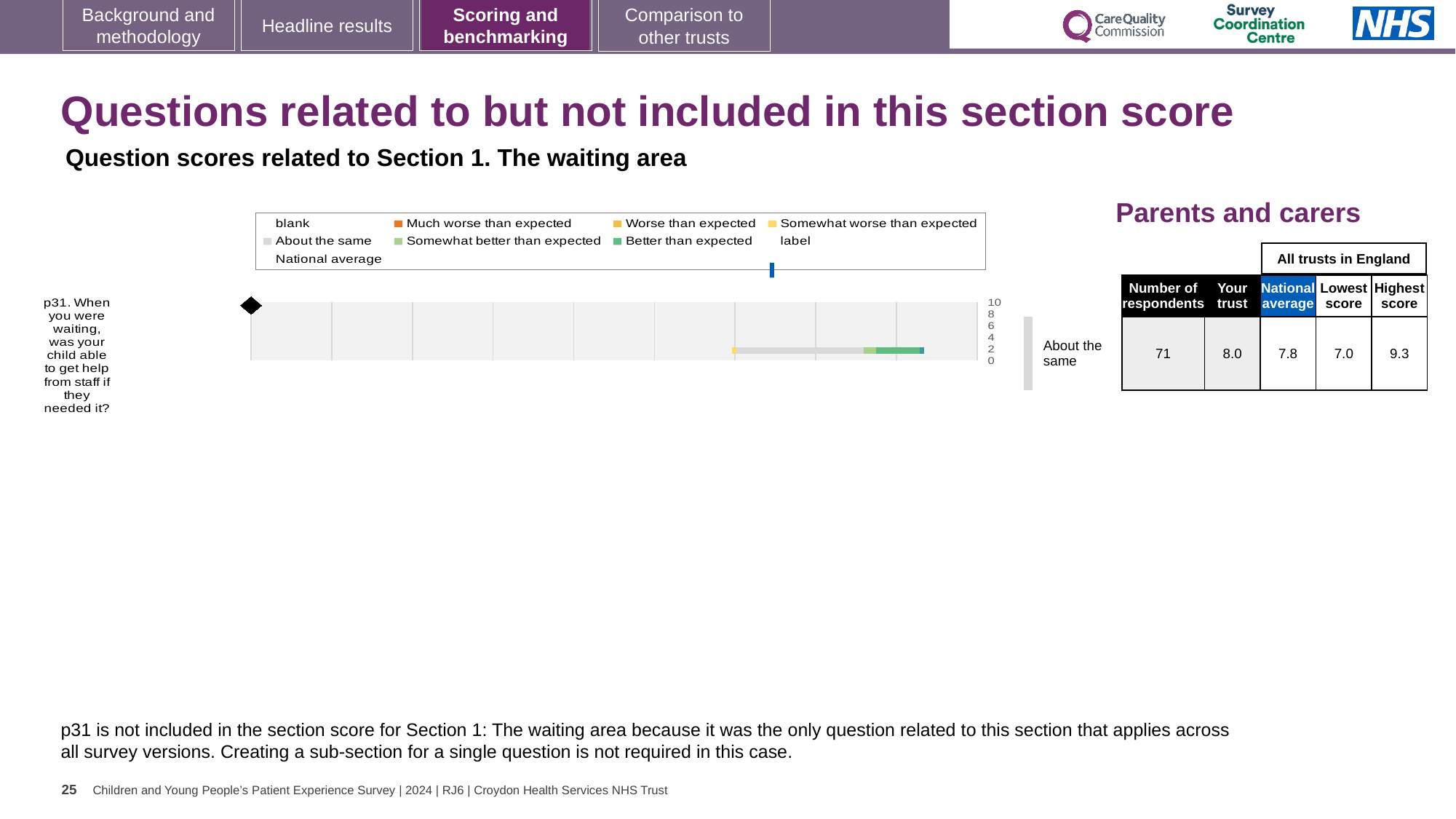
What is the highest score among all trusts in England for p31? 9.3 How many questions (categories) are plotted in the chart? 1 What is the 'Your trust' score for p31 in the table? 8.0 What is the difference between the 'Your trust' score and the national average for p31? 0.2 What is the number of respondents for p31? 71 What kind of chart is shown on the slide? bar chart Which question is plotted in the chart? p31. When you were waiting, was your child able to get help from staff if they needed it? What is the national average score for p31 in the table? 7.8 Which is larger for p31, the 'Your trust' score or the national average? Your trust What is the difference between the highest score and the lowest score for p31? 2.3 What is the lowest score among all trusts in England for p31? 7.0 What benchmark category label is shown to the right of the chart for p31? About the same